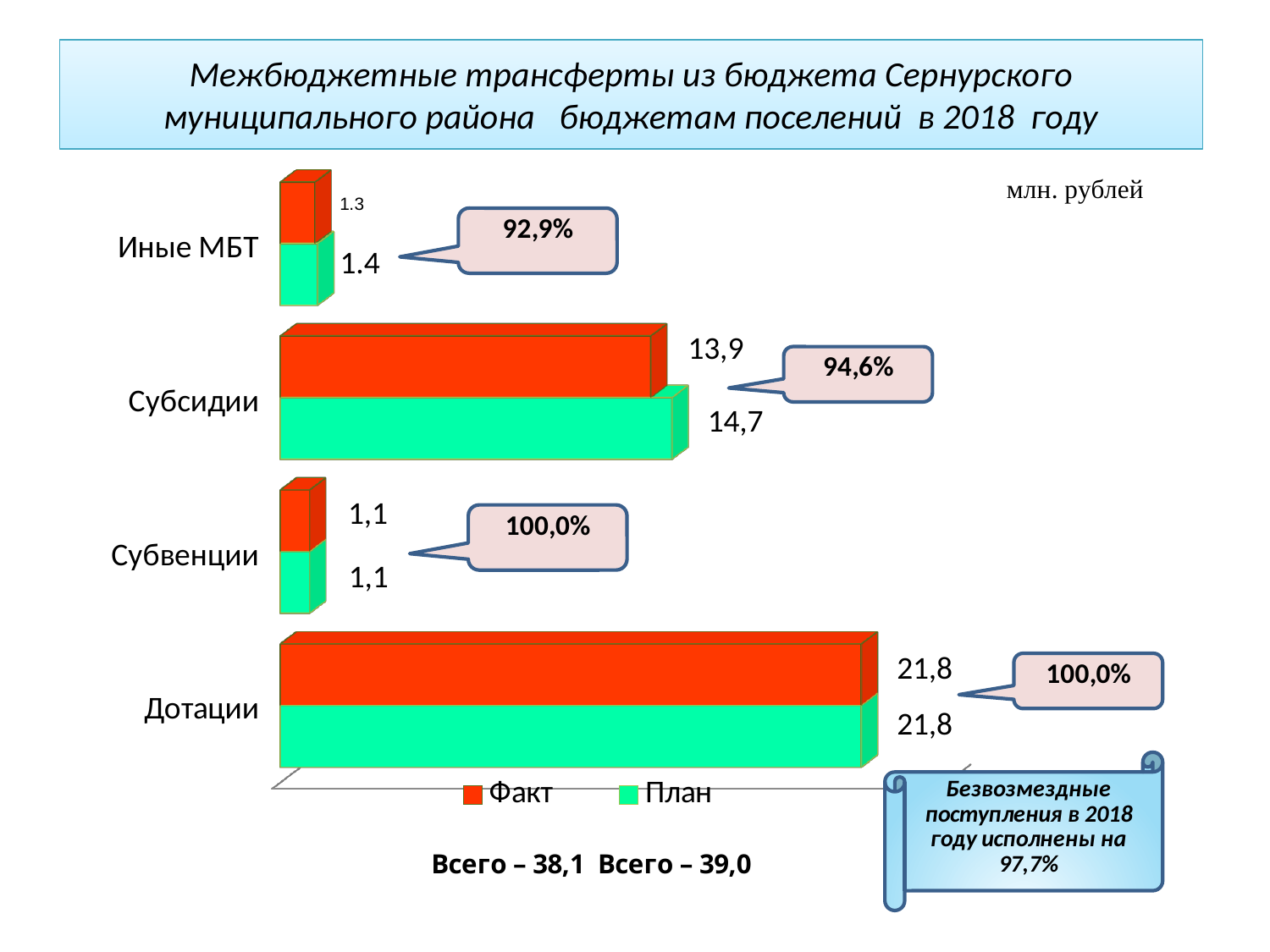
Which category has the lowest План value? Субвенции What kind of chart is shown on the slide? Bar chart What is the План value for Субвенции? 1,1 How many categories are shown on the chart? 4 What is the difference between the План and Факт values for Субсидии? 0,8 What is the План value for Субсидии? 14,7 Which is larger for Субсидии, the Факт value or the План value? План Which category has the highest Факт value? Дотации What is the Факт value for Иные МБТ? 1.3 What is the План value for Дотации? 21,8 How many series does the legend list? 2 What is the Факт value for Субсидии? 13,9